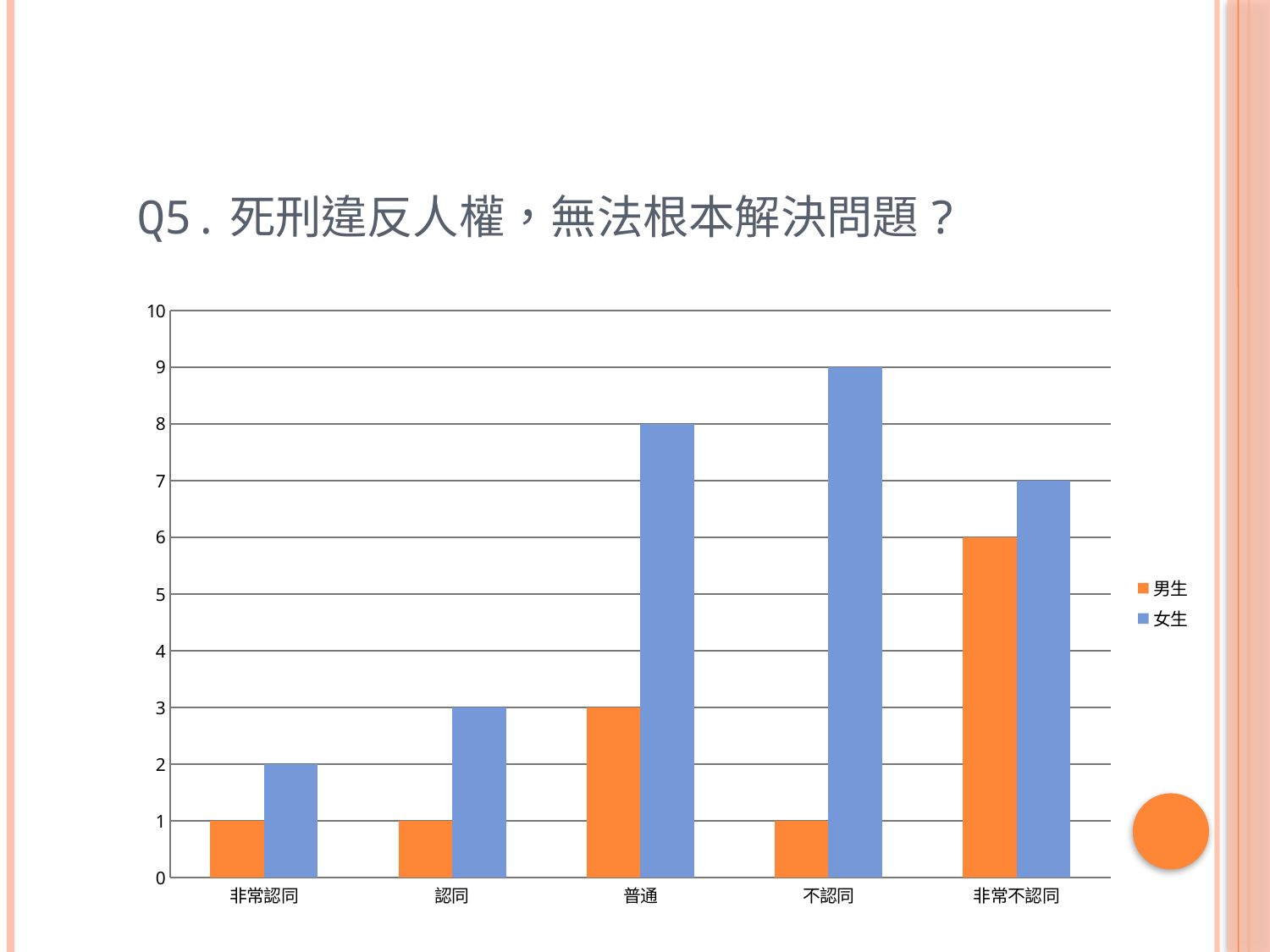
Which category has the highest value for 男生? 非常不認同 Which category has the highest value for 女生? 不認同 What is the value for 男生 in the 非常不認同 category? 6 What kind of chart is shown on the slide? bar chart Which is larger in the 非常不認同 category, the value for 男生 or for 女生? 女生 What is the difference between the 女生 and 男生 values in the 不認同 category? 8 How many series does the legend list? 2 What is the value for 女生 in the 不認同 category? 9 Which colour represents 男生 in the chart? orange What is the value for 女生 in the 普通 category? 8 How many categories are shown on the x axis? 5 Is the value for 女生 in the 認同 category greater or less than 5? less